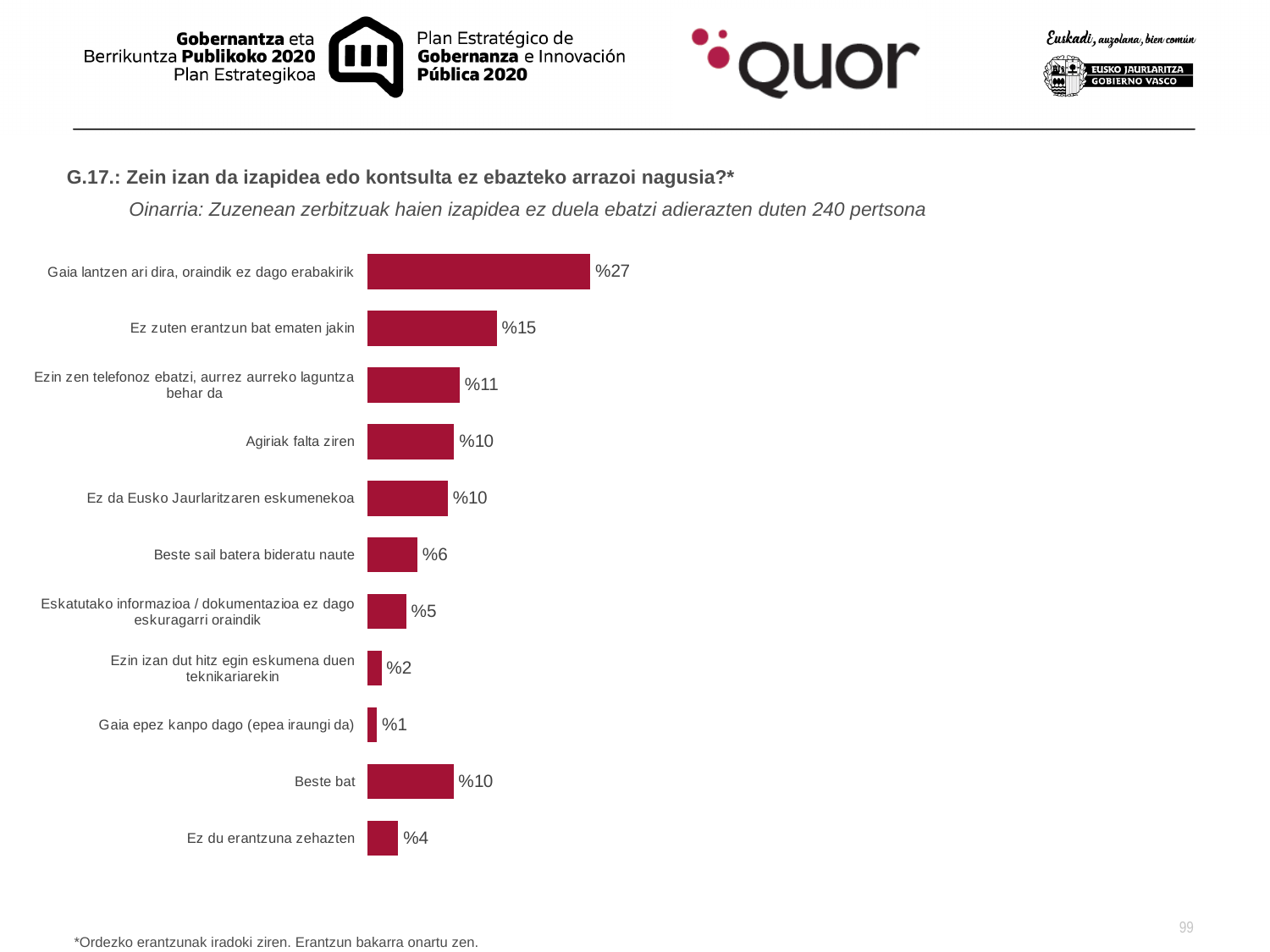
What is the value for "Ez zuten erantzun bat ematen jakin"? %15 What is the value for "Ezin izan dut hitz egin eskumena duen teknikariarekin"? %2 What colour are the bars in the chart? Red What is the value for "Gaia lantzen ari dira, oraindik ez dago erabakirik"? %27 Which category has the lowest value? Gaia epez kanpo dago (epea iraungi da) What is the value for "Ez du erantzuna zehazten"? %4 Which is larger: the value for "Ezin zen telefonoz ebatzi, aurrez aurreko laguntza behar da" or the value for "Beste sail batera bideratu naute"? Ezin zen telefonoz ebatzi, aurrez aurreko laguntza behar da What is the value for "Beste sail batera bideratu naute"? %6 Which category has the highest value? Gaia lantzen ari dira, oraindik ez dago erabakirik How many categories are shown in the chart? 11 What is the difference between the values for "Gaia lantzen ari dira, oraindik ez dago erabakirik" and "Ez zuten erantzun bat ematen jakin"? 12 percentage points What kind of chart is shown on the slide? Bar chart